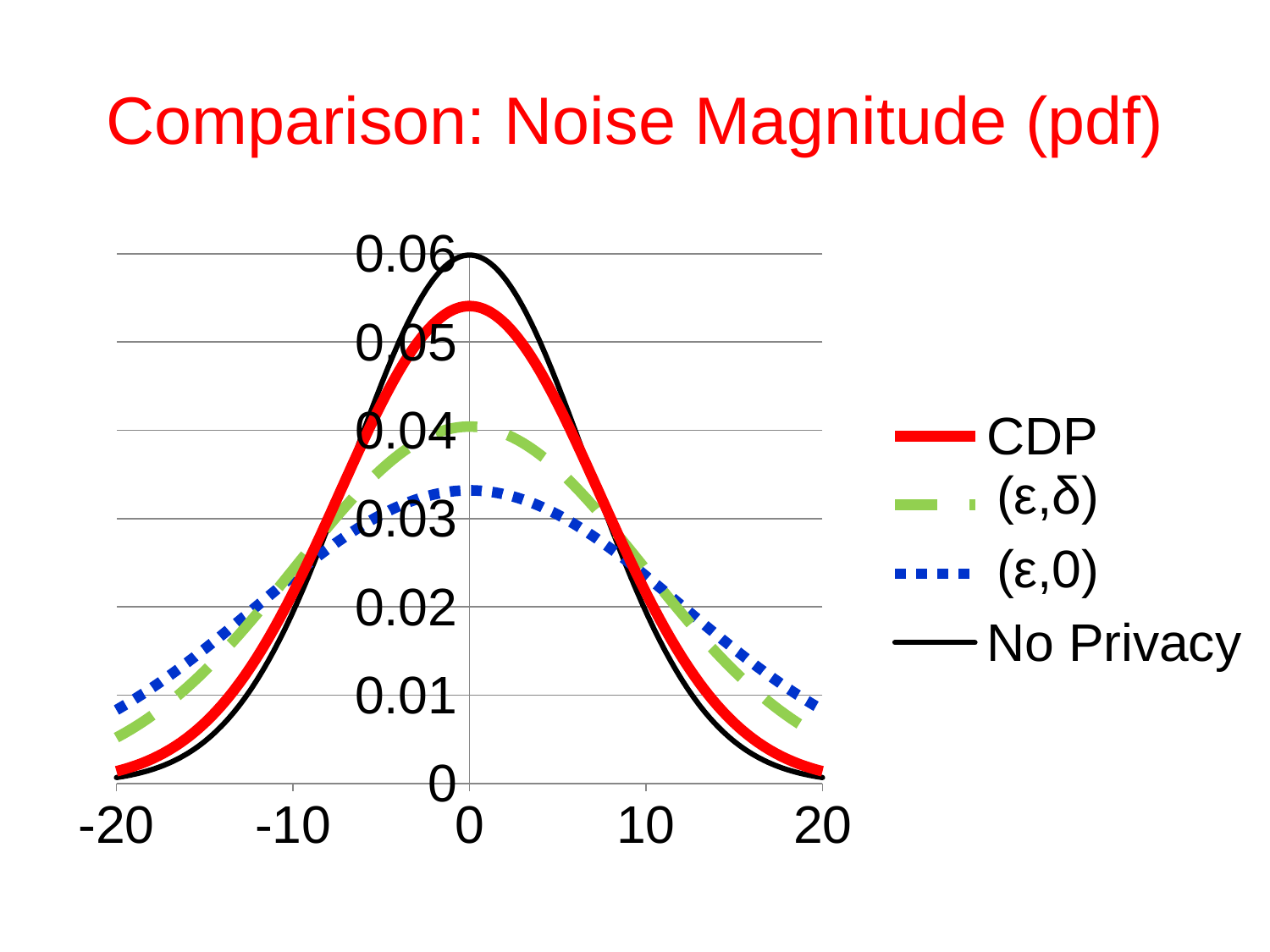
At x = 0, which is larger: the CDP series or the (ε,0) series? CDP Which series is drawn as a blue dotted line? (ε,0) Is the value of the CDP series at x = -20 greater or less than 0.01? less How many series does the legend list? 4 How does the No Privacy series change as x goes from -20 to 20? Rises to a peak at 0, then falls Which series reaches the highest peak at x = 0? No Privacy What is the title of the chart? Comparison: Noise Magnitude (pdf) Is the value of the (ε,0) series at x = 0 greater or less than 0.04? less Which series has the lowest peak at x = 0? (ε,0) Is the value of the CDP series at x = 0 greater or less than 0.05? greater What kind of chart is shown on the slide? Line chart At x = -20, which is larger: the (ε,0) series or the No Privacy series? (ε,0)